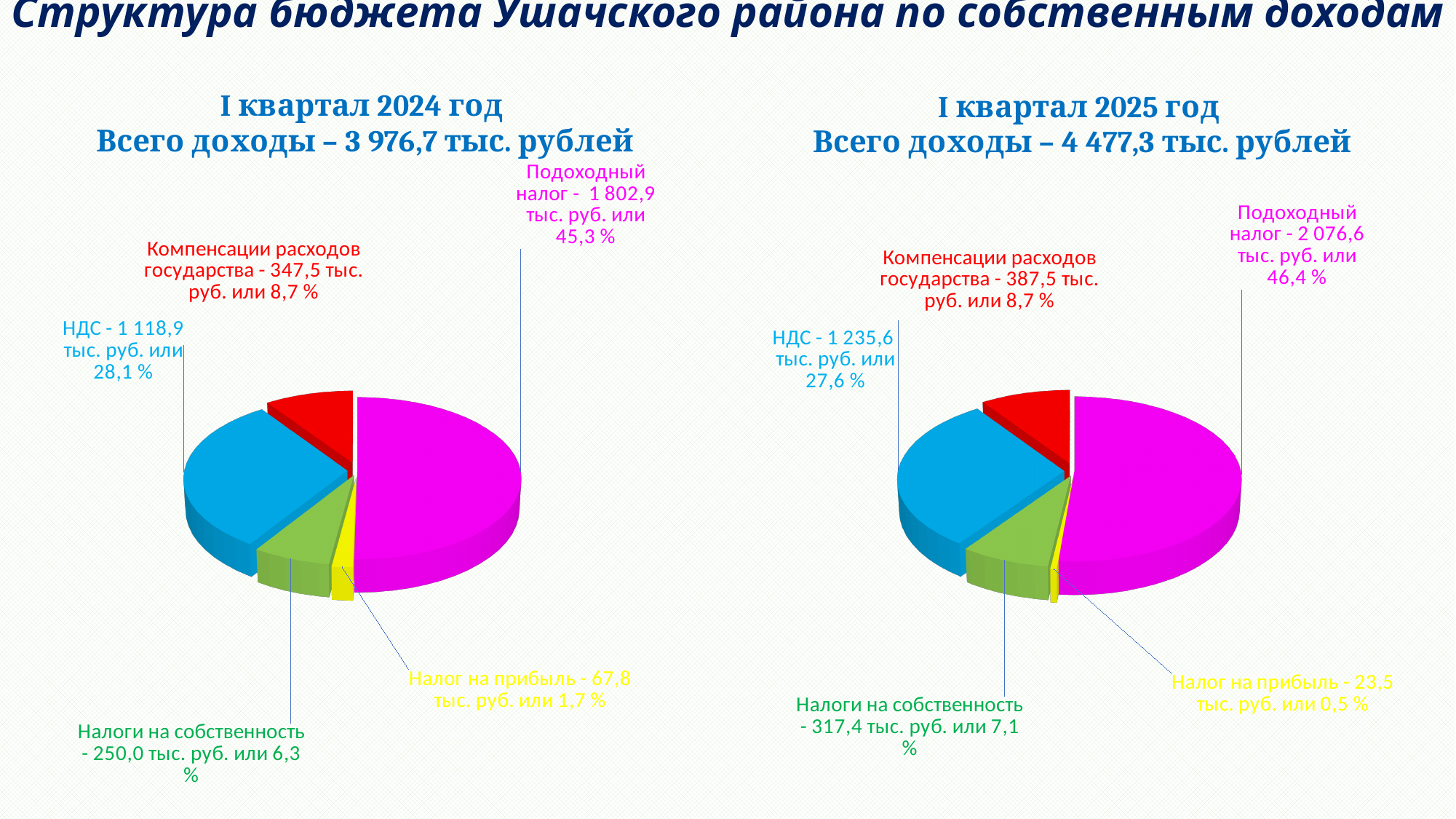
In the 'I квартал 2024 год' chart, what is the value for Подоходный налог? 1 802,9 тыс. руб. How many categories are shown in the 'I квартал 2024 год' chart? 5 In the 'I квартал 2025 год' chart, what is the value for Налоги на собственность? 317,4 тыс. руб. In the 'I квартал 2025 год' chart, which category has the smallest slice? Налог на прибыль In the 'I квартал 2025 год' chart, what share of the pie is НДС? 27,6 % In the 'I квартал 2024 год' chart, what is the difference between the values for НДС and Компенсации расходов государства? 771,4 тыс. руб. In the 'I квартал 2025 год' chart, which is larger: Компенсации расходов государства or Налоги на собственность? Компенсации расходов государства In the 'I квартал 2024 год' chart, what colour is the НДС slice? Blue What total income is stated in the title of the 'I квартал 2025 год' chart? 4 477,3 тыс. рублей In the 'I квартал 2024 год' chart, which category has the largest slice? Подоходный налог What kind of chart is used for 'I квартал 2025 год'? Pie chart In the 'I квартал 2024 год' chart, what share of the pie is Налог на прибыль? 1,7 %